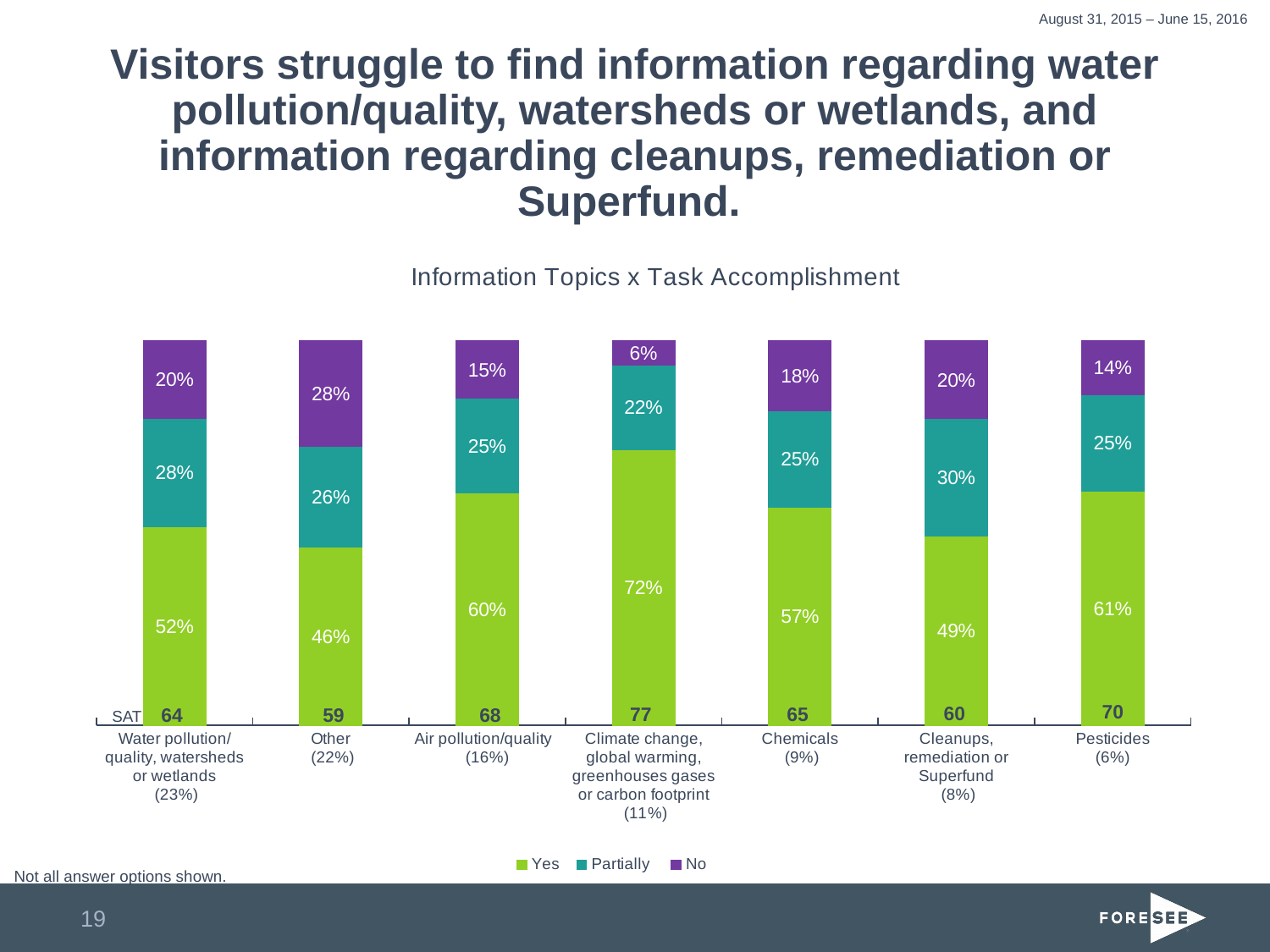
What kind of chart is shown on the slide? Stacked bar chart Which information topic has the highest "Yes" percentage? Climate change, global warming, greenhouses gases or carbon footprint What is the "Partially" percentage for Cleanups, remediation or Superfund? 30% What is the difference between the "Yes" percentage for Pesticides and the "Yes" percentage for Water pollution/quality, watersheds or wetlands? 9% What percentage of visitors answered "Yes" for Climate change, global warming, greenhouses gases or carbon footprint? 72% Which information topic has the lowest "Yes" percentage? Other Which is larger: the "No" percentage for Chemicals or the "No" percentage for Pesticides? Chemicals What is the title of the chart? Information Topics x Task Accomplishment What is the "No" percentage for the Other category? 28% How many series does the legend list? 3 How many information topics are shown on the chart? 7 What is the SAT score shown for Air pollution/quality? 68